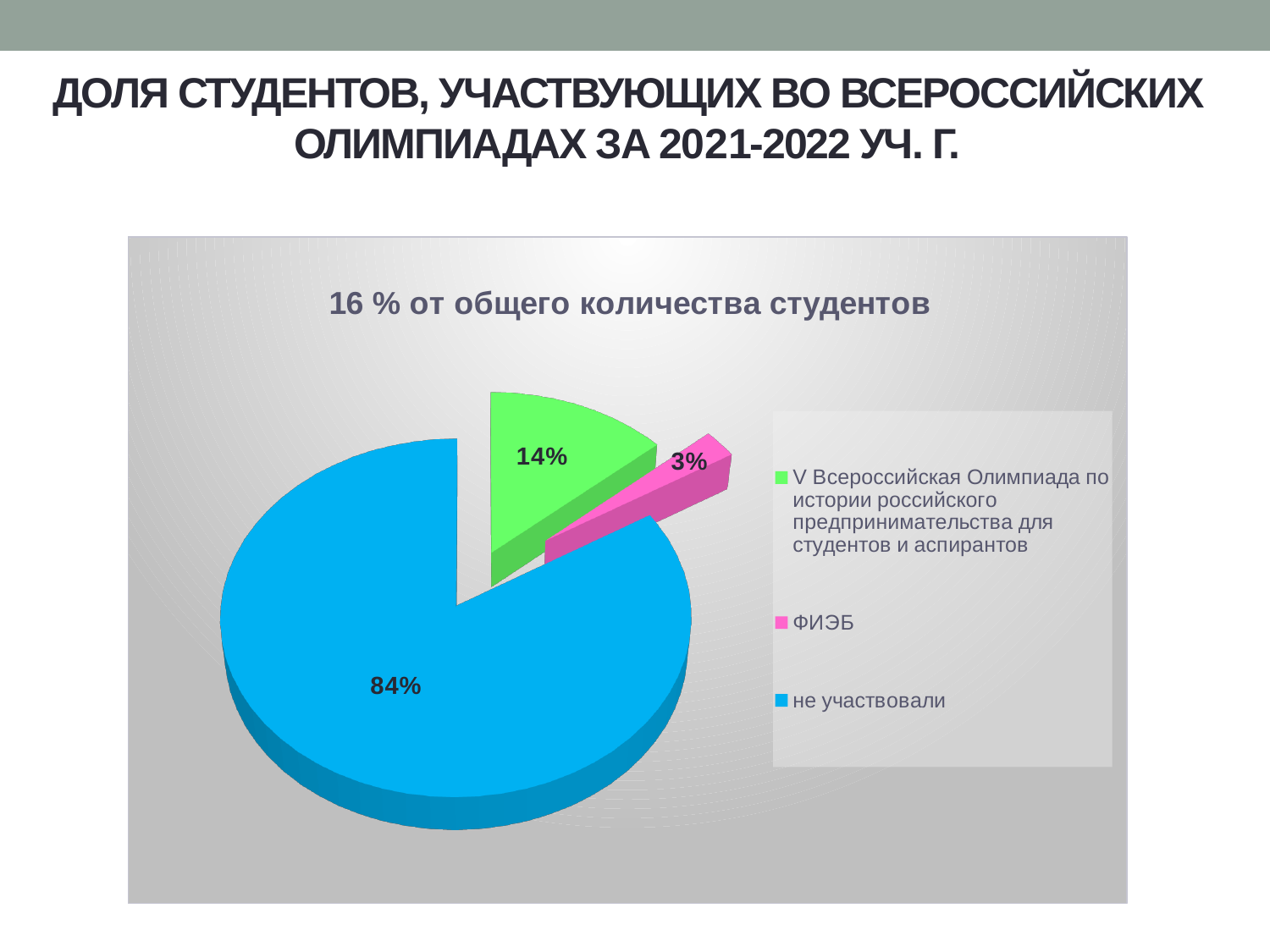
How many slices does the pie chart have? 3 What share of the pie is labelled "V Всероссийская Олимпиада по истории российского предпринимательства для студентов и аспирантов"? 14% What kind of chart is shown on the slide? pie chart What share of the pie is labelled "не участвовали"? 84% What is the title shown inside the chart area? 16 % от общего количества студентов Which slice is larger: "ФИЭБ" or "V Всероссийская Олимпиада по истории российского предпринимательства"? V Всероссийская Олимпиада по истории российского предпринимательства What colour is the "ФИЭБ" slice? pink How many entries does the legend list? 3 What share of the pie is labelled "ФИЭБ"? 3% Which category has the smallest slice of the pie? ФИЭБ Which category has the largest slice of the pie? не участвовали What is the difference in percentage points between the "не участвовали" slice and the "V Всероссийская Олимпиада" slice? 70